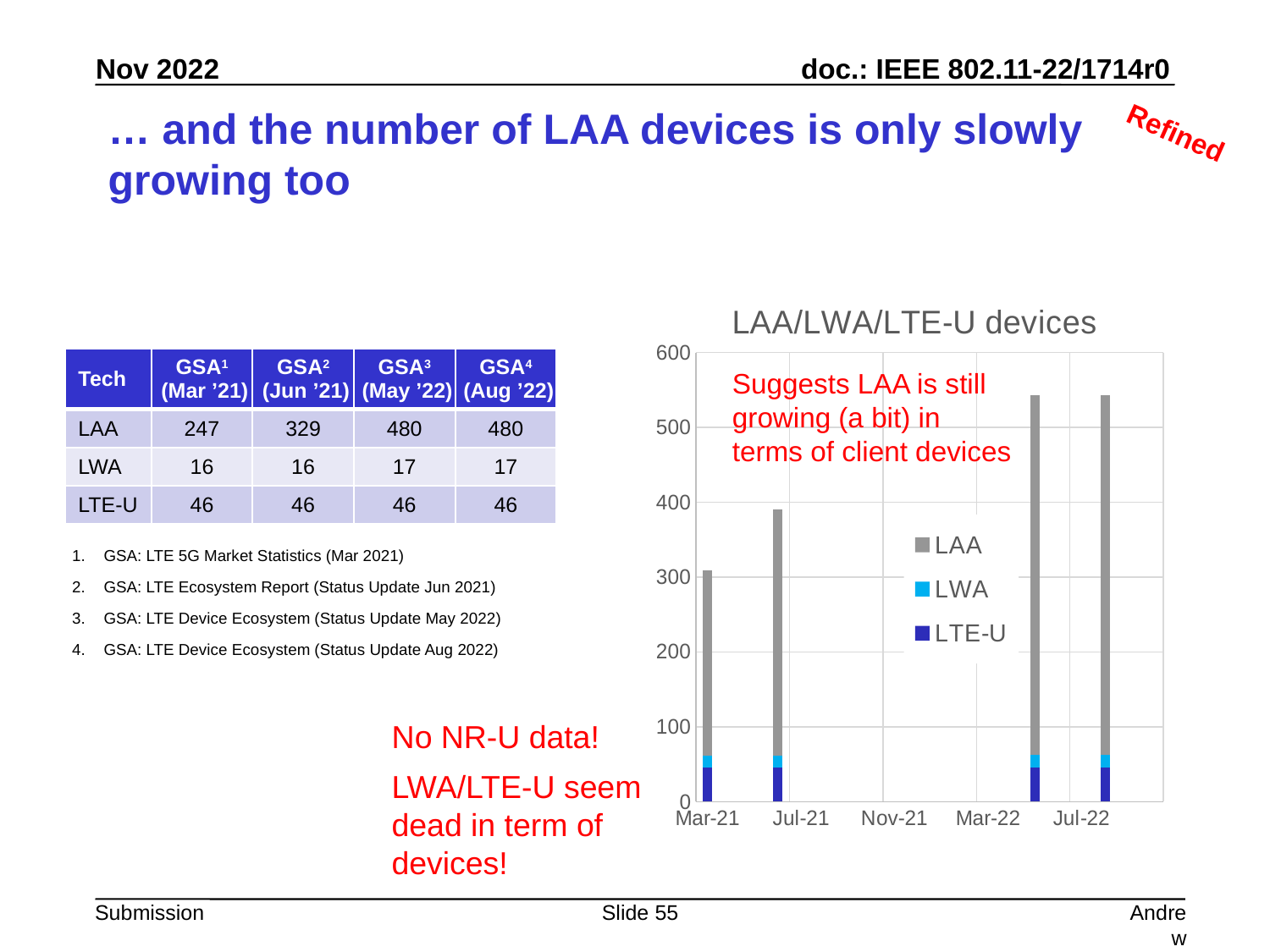
Is the total height of the first bar (at Mar-21) greater or less than 400? less Is the total height of the last bar (near Jul-22) greater or less than 600? less What is the title of the chart? LAA/LWA/LTE-U devices How many series does the chart's legend list? 3 What kind of chart is shown on the slide? Stacked bar chart Is the total height of the bar just after Mar-22 greater or less than 500? greater Which bar is taller, the one at Mar-21 or the one near Jul-21? Jul-21 Which bar has the lowest total height? Mar-21 Which series is shown in grey in the chart? LAA Do the total bar heights rise or fall from left to right along the x axis? Rise How many bars are plotted in the chart? 4